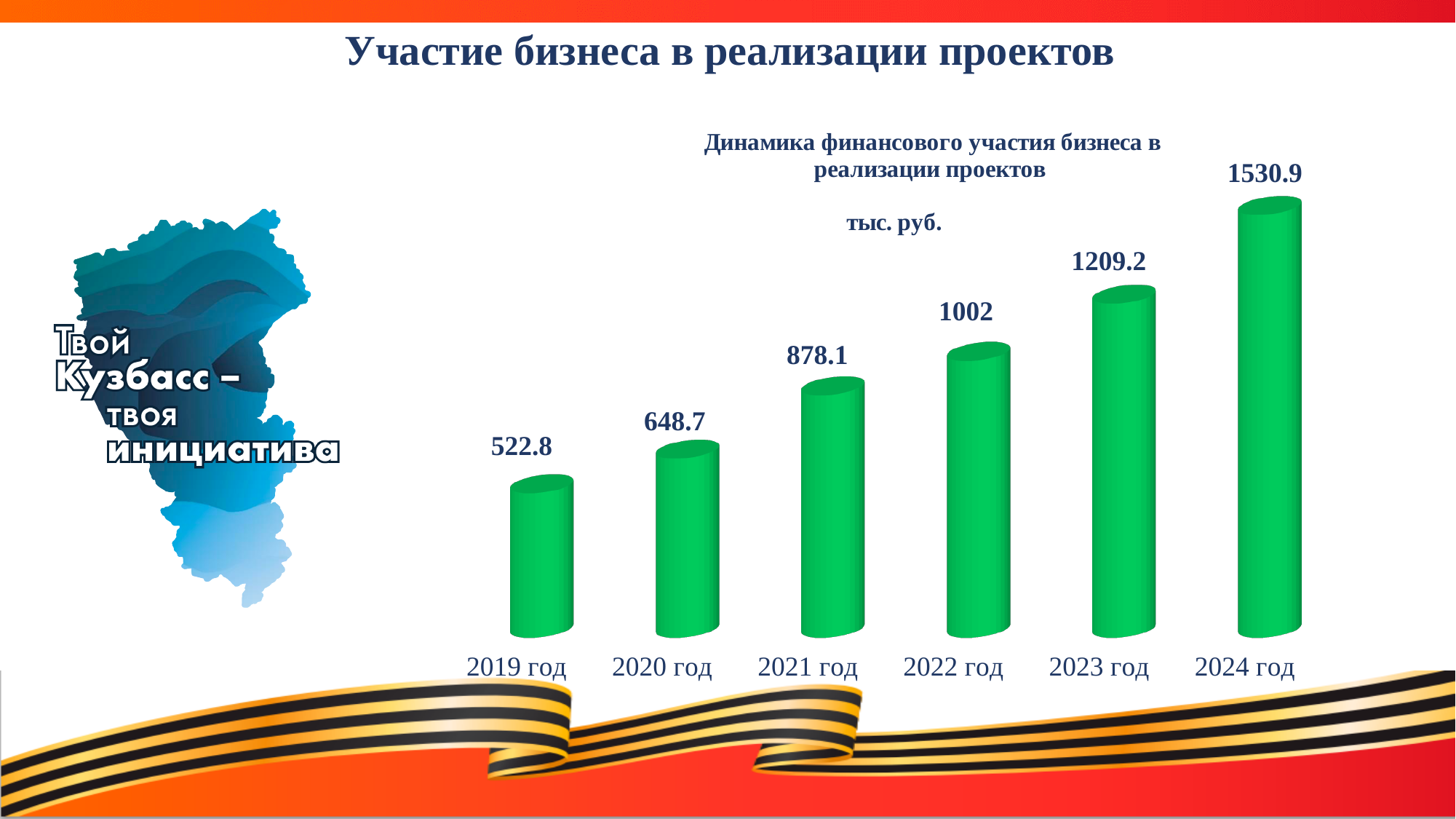
What kind of chart is this? bar chart What is the value for 2024 год? 1530.9 What is the difference between the values for 2020 год and 2019 год? 125.9 How many years are shown on the chart? 6 Do the values rise or fall from 2019 год to 2024 год? rise Which is larger, the value for 2021 год or the value for 2022 год? 2022 год What unit is stated for the chart values? тыс. руб. What is the difference between the values for 2024 год and 2023 год? 321.7 What is the value for 2022 год? 1002 Which year has the highest value? 2024 год What is the value for 2019 год? 522.8 Which year has the lowest value? 2019 год